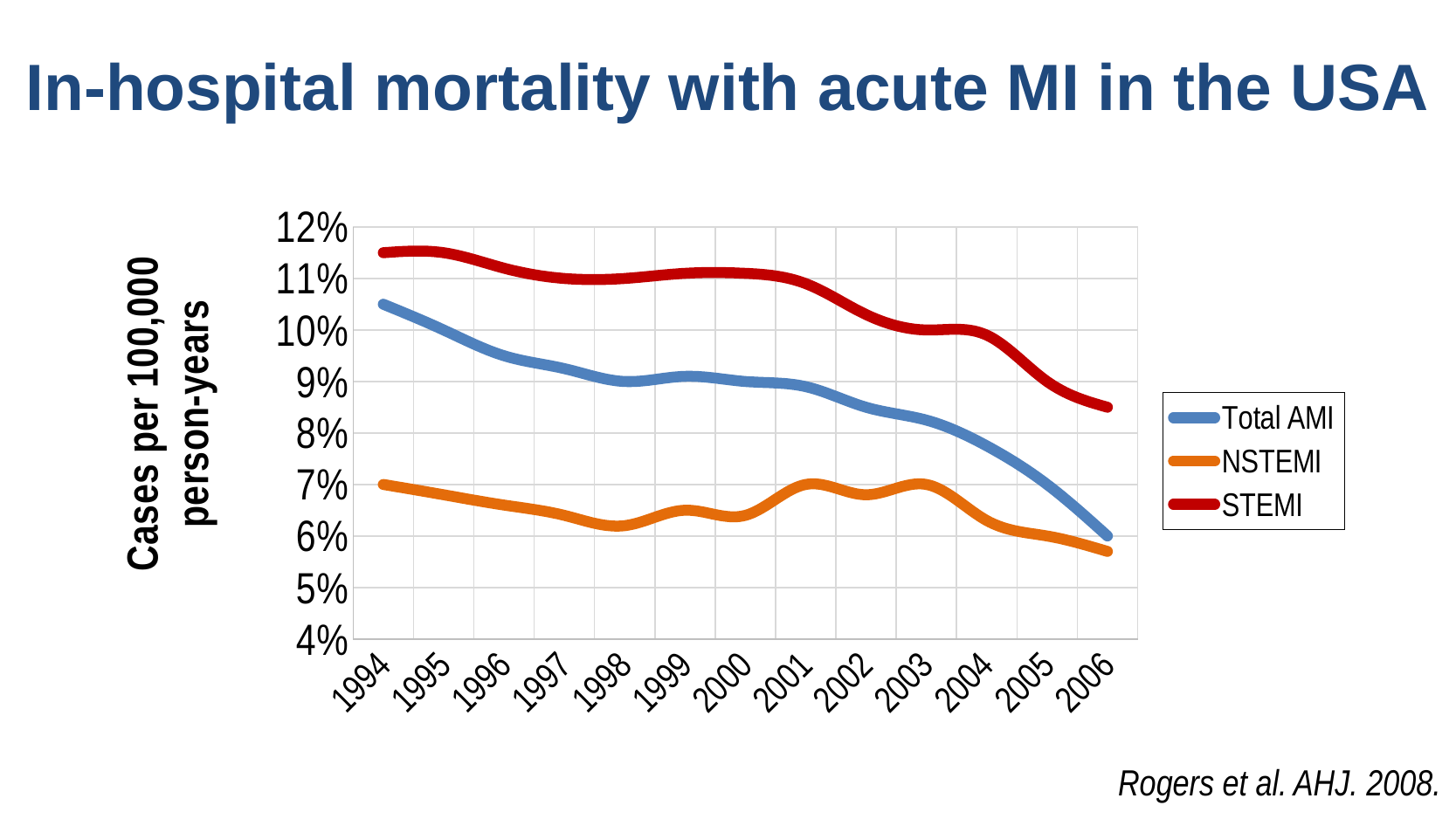
How many series does the legend list? 3 Which series has the lowest value in 1996? NSTEMI Is the NSTEMI value for 1998 greater or less than 7%? less What kind of chart is shown on the slide? line chart Which is larger in 2000, the STEMI value or the NSTEMI value? STEMI Is the STEMI value for 1994 greater or less than 11%? greater What colour is the STEMI line in the legend? red How many years are shown along the x axis? 13 What is the title of the slide? In-hospital mortality with acute MI in the USA Does the Total AMI line rise or fall from 1994 to 2006? fall Is the Total AMI value for 2006 greater or less than 7%? less Which series has the highest value in 2003? STEMI